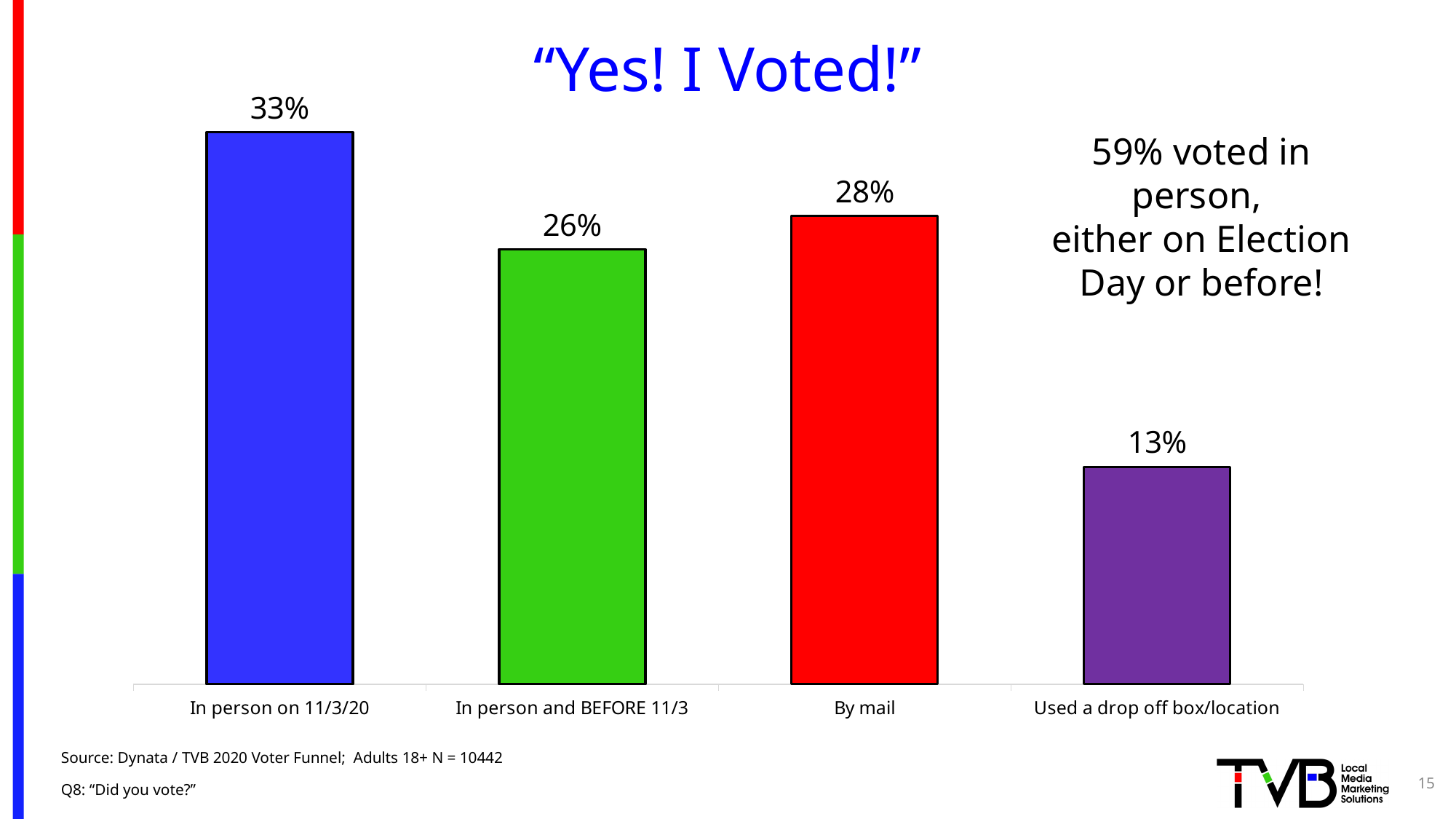
What type of chart is shown on the slide? Bar chart What percentage of respondents voted in person on 11/3/20? 33% What colour is the bar for 'By mail'? Red Which voting method has the lowest percentage? Used a drop off box/location What is the difference in percentage points between voting by mail and using a drop off box/location? 15 What percentage of respondents used a drop off box/location? 13% What is the difference in percentage points between voting in person on 11/3/20 and voting in person and BEFORE 11/3? 7 Which voting method has the highest percentage? In person on 11/3/20 How many voting method categories are shown in the chart? 4 What is the title of the slide? "Yes! I Voted!" What percentage of respondents voted by mail? 28% Which is larger: the percentage who voted by mail or the percentage who voted in person and BEFORE 11/3? By mail